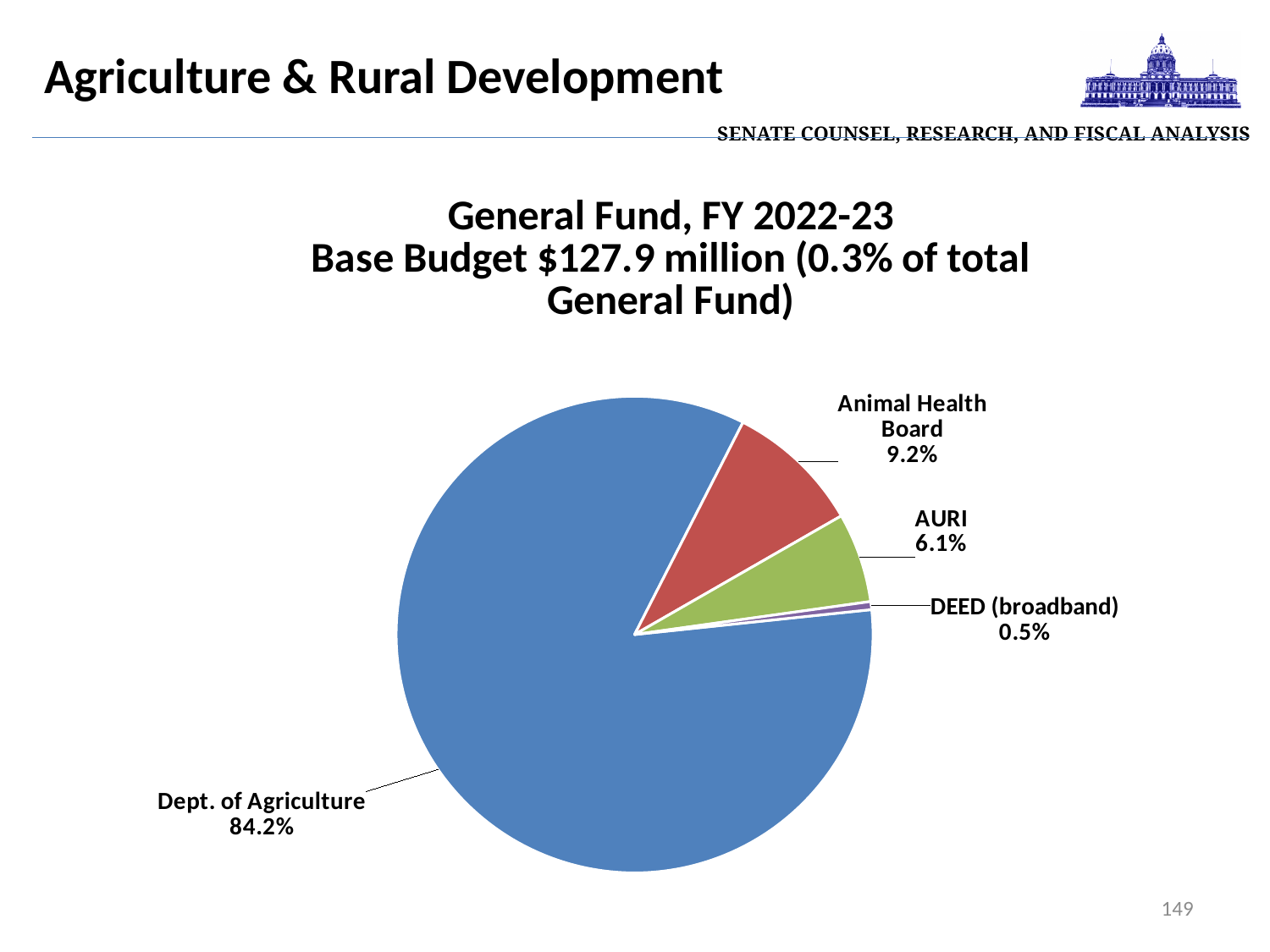
Which slice of the pie is the smallest? DEED (broadband) What share of the pie does DEED (broadband) hold? 0.5% How many slices does the pie chart have? 4 Which slice of the pie is the largest? Dept. of Agriculture What is the difference in percentage points between Animal Health Board and AURI? 3.1 What is the base budget amount stated in the chart title? $127.9 million What share of the pie does Dept. of Agriculture hold? 84.2% What colour is the Dept. of Agriculture slice? blue What kind of chart is shown on the slide? pie chart What share of the pie does Animal Health Board hold? 9.2% Which is larger, the share for AURI or the share for Animal Health Board? Animal Health Board